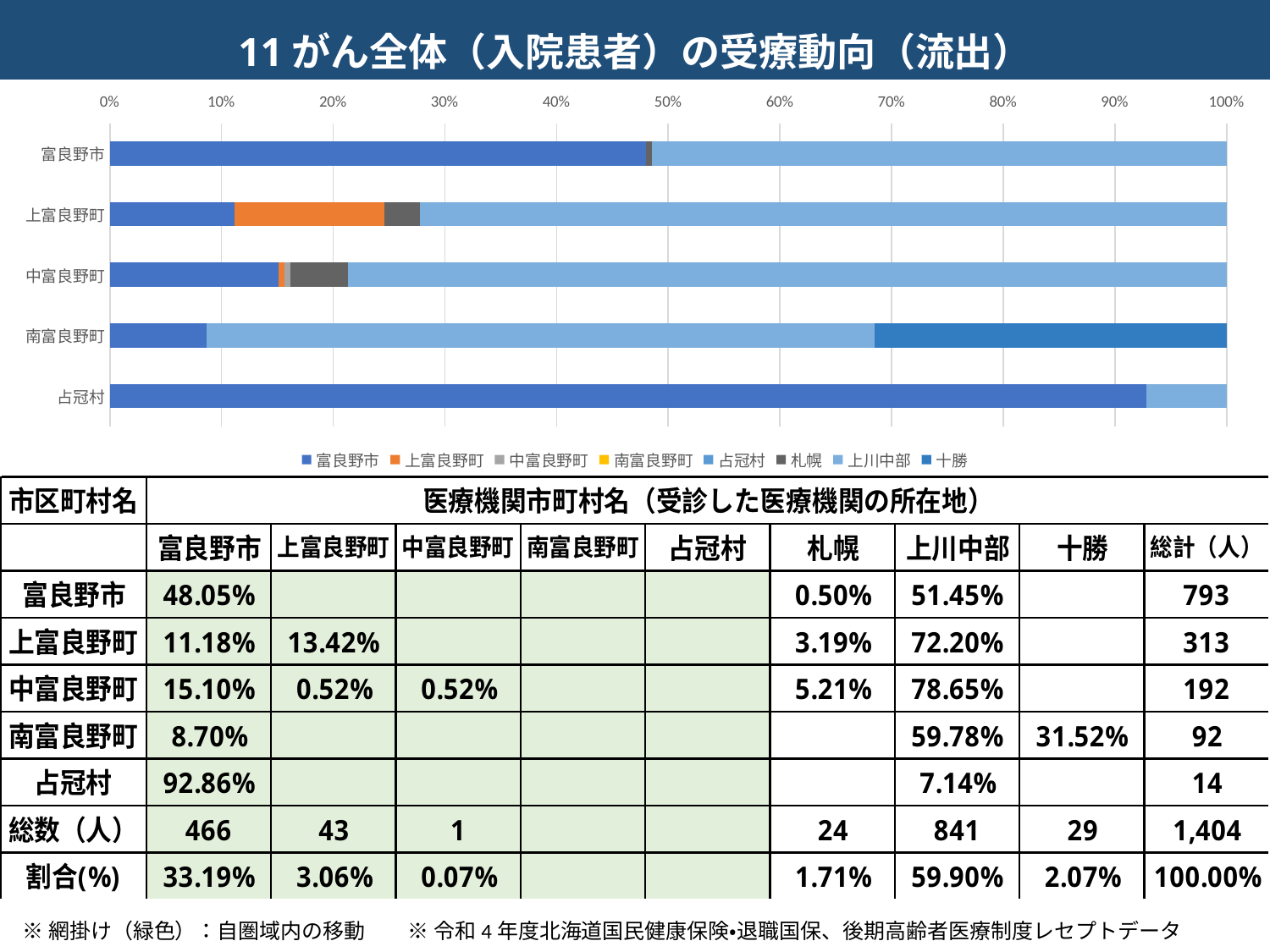
What kind of chart is shown on the slide? Stacked bar chart How many series does the chart legend list? 8 What is the 札幌 share for 中富良野町? 5.21% Is the 富良野市 segment for 南富良野町 greater or less than 10%? less Which municipality is the only one with a 十勝 segment in its bar? 南富良野町 How many municipalities (categories) are plotted on the y axis of the chart? 5 What is the 上川中部 share for 富良野市? 51.45% Which has the larger 上川中部 share, 上富良野町 or 中富良野町? 中富良野町 Which municipality has the smallest 富良野市 segment in its bar? 南富良野町 What is the 富良野市 share for 占冠村? 92.86% What is the difference between the 上川中部 share and the 富良野市 share for 富良野市? 3.40% Which municipality has the largest 富良野市 segment in its bar? 占冠村